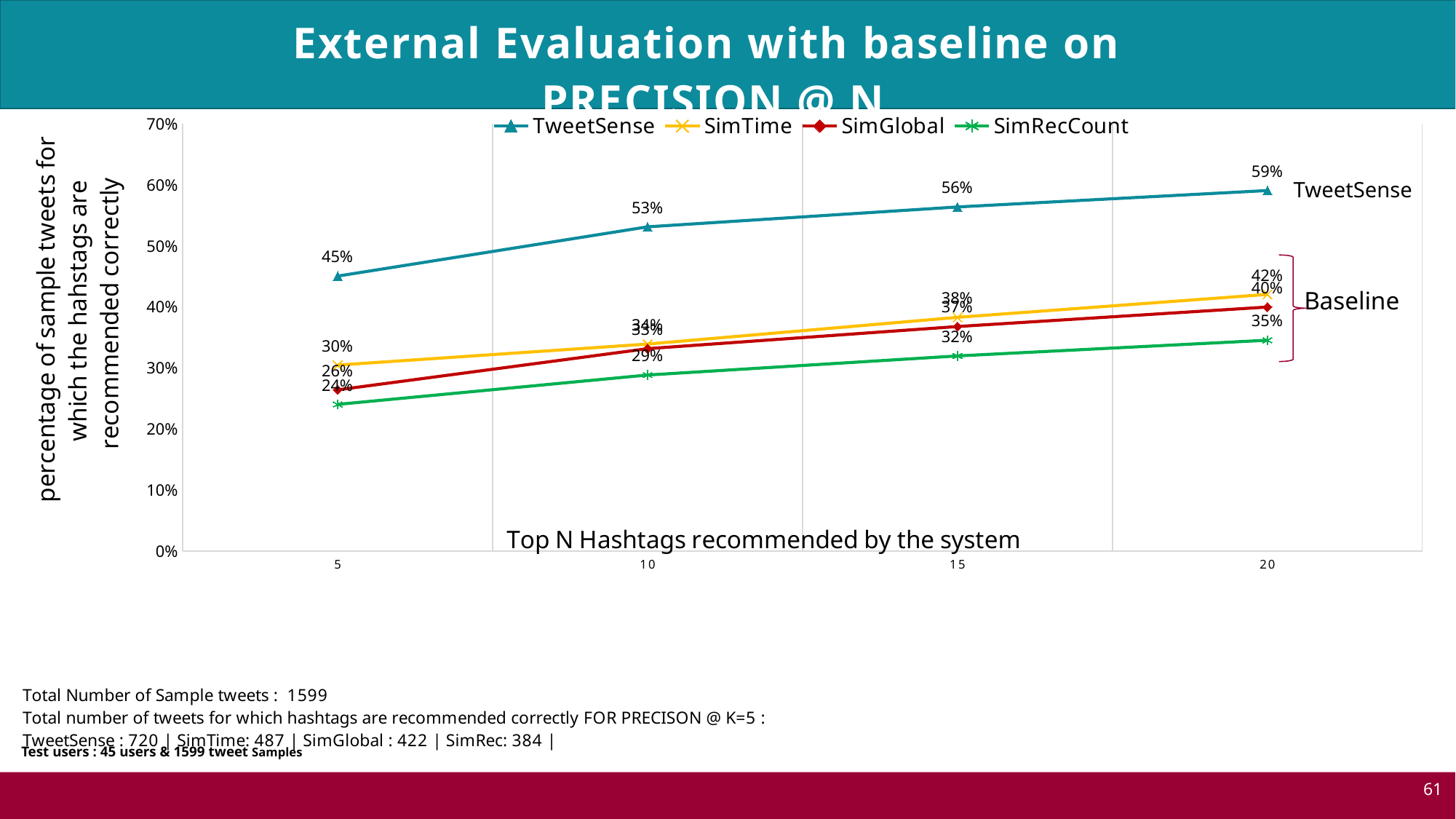
Which series has the highest value at N = 20? TweetSense Which series has the lowest value at N = 5? SimRecCount What is the value for SimTime at N = 5? 30% What is the value for TweetSense at N = 20? 59% What type of chart is shown on the slide? line chart Does the TweetSense series rise or fall as N increases from 5 to 20? rise How many points are plotted along the x axis for each series? 4 What is the difference between TweetSense and SimRecCount at N = 20? 24% What is the value for TweetSense at N = 5? 45% What is the value for SimRecCount at N = 10? 29% How many series does the legend list? 4 Which series is plotted with a green line? SimRecCount